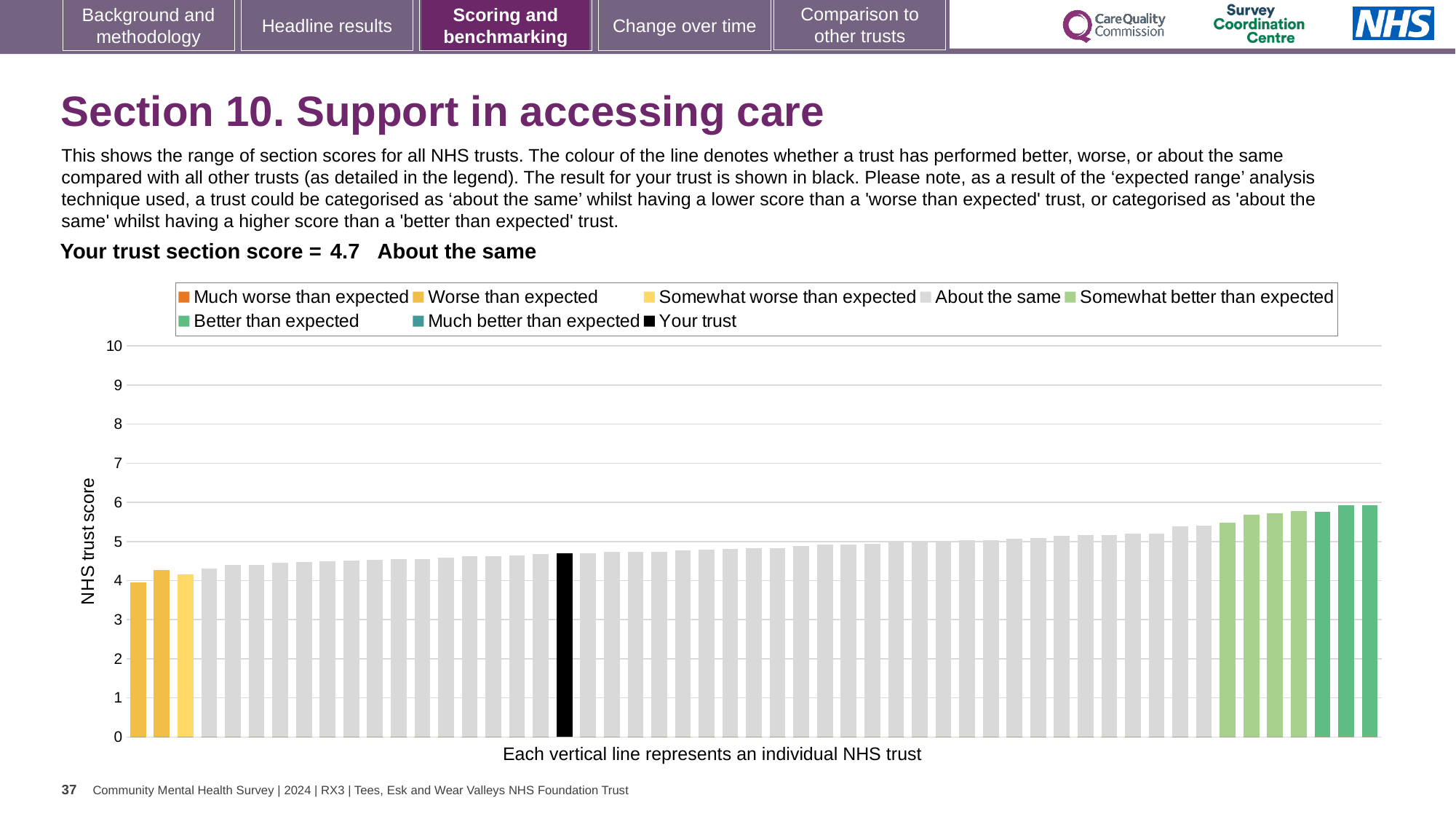
How many bars are coloured as 'Better than expected'? 3 Do the bar values rise or fall from left to right along the x axis? rise What kind of chart is shown on the slide? bar chart How many entries does the chart legend list? 8 What is the section score for your trust shown on the slide? 4.7 What is the highest value shown on the vertical axis? 10 Is the value of the black 'Your trust' bar greater or less than 5? less Which category does your trust fall into according to the slide? About the same Is the value of the shortest bar in the chart greater or less than 3? greater What is the label on the vertical axis of the chart? NHS trust score Is the value of the black 'Your trust' bar greater or less than 4? greater